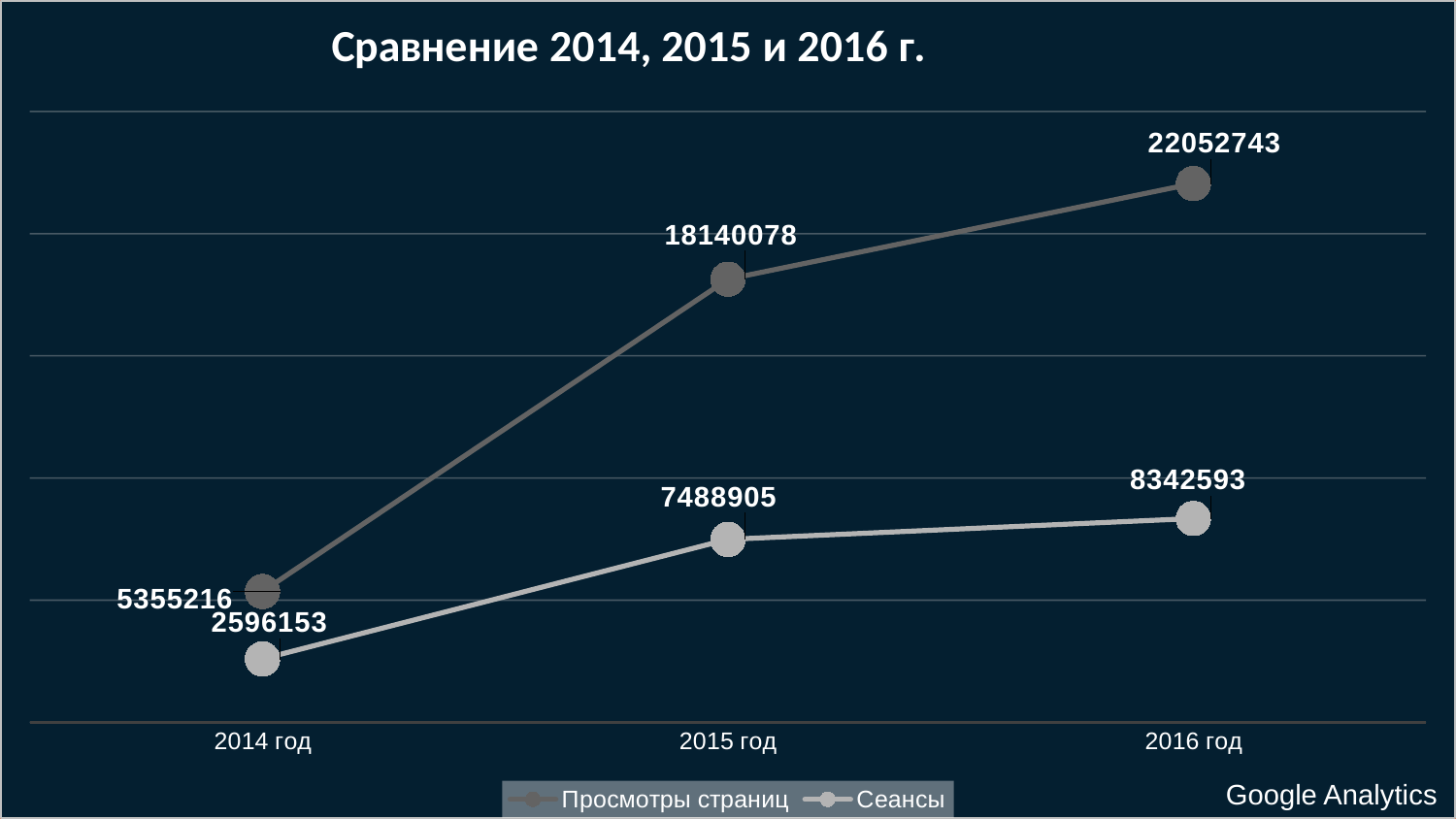
In which year is Сеансы lowest? 2014 год How many series does the legend list? 2 What is the difference between Просмотры страниц in 2016 год and 2015 год? 3912665 What type of chart is shown on the slide? Line chart What is the value of Сеансы for 2016 год? 8342593 How many years are plotted on the x axis? 3 What is the difference between Просмотры страниц and Сеансы in 2014 год? 2759063 What is the value of Просмотры страниц for 2015 год? 18140078 Which is larger in 2015 год: Просмотры страниц or Сеансы? Просмотры страниц What is the value of Сеансы for 2014 год? 2596153 Do the values of Сеансы rise or fall from 2014 год to 2016 год? Rise In which year is Просмотры страниц highest? 2016 год